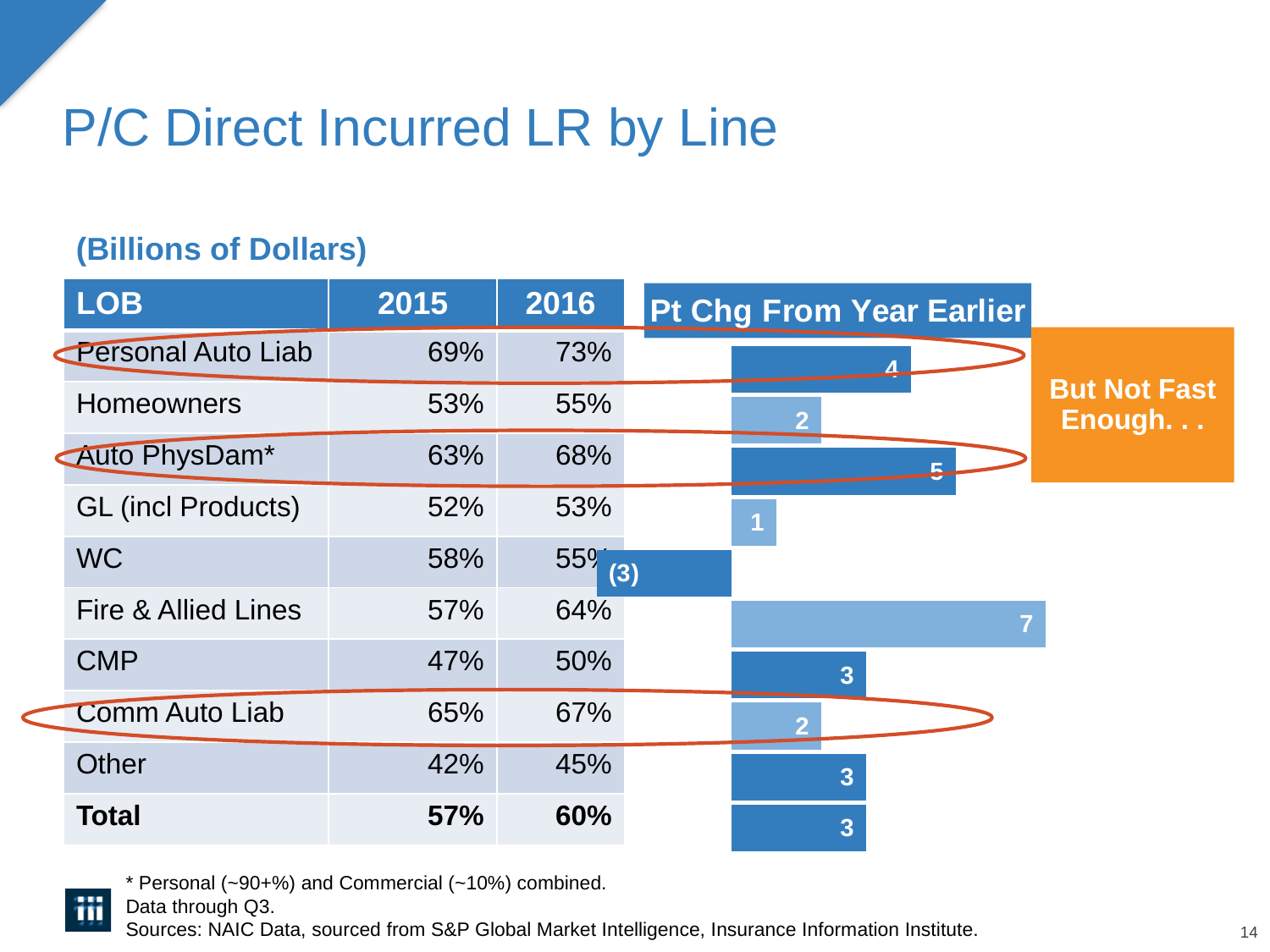
In the 'Pt Chg From Year Earlier' chart, what is the value for Auto PhysDam*? 5 In the 'Pt Chg From Year Earlier' chart, what is the value for Total? 3 How many bars are plotted in the 'Pt Chg From Year Earlier' chart? 10 What kind of chart is used to show the 'Pt Chg From Year Earlier' values? bar chart In the 'Pt Chg From Year Earlier' chart, which line of business has the highest point change? Fire & Allied Lines In the 'Pt Chg From Year Earlier' chart, which is larger: the value for Personal Auto Liab or the value for Homeowners? Personal Auto Liab In the 'Pt Chg From Year Earlier' chart, what is the difference between the values for Fire & Allied Lines and Auto PhysDam*? 2 In the 'Pt Chg From Year Earlier' chart, what is the value for Personal Auto Liab? 4 What is the title of the bar chart on the slide? Pt Chg From Year Earlier In the 'Pt Chg From Year Earlier' chart, what is the value for WC? (3) In the 'Pt Chg From Year Earlier' chart, which line of business has the lowest point change? WC In the 'Pt Chg From Year Earlier' chart, what is the value for Fire & Allied Lines? 7